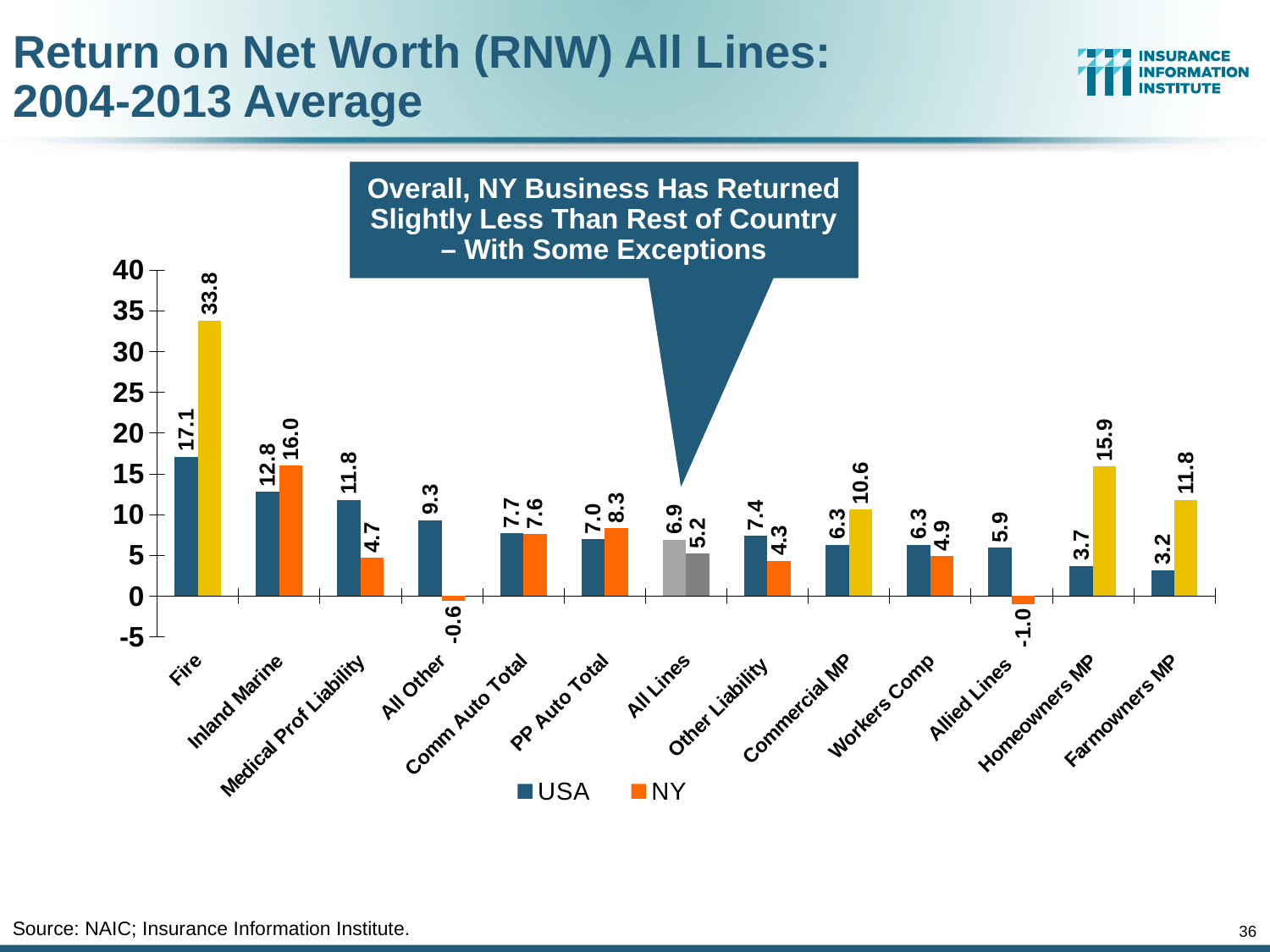
What is the USA value for All Lines? 6.9 What is the difference between the NY and USA values for Fire? 16.7 What is the NY value for All Other? -0.6 Which is larger for Medical Prof Liability, the USA value or the NY value? USA Which category has the lowest NY value? Allied Lines Is the NY value for Commercial MP greater or less than 10? greater What kind of chart is shown on the slide? bar chart How many series does the legend list? 2 How many categories are shown on the x axis? 13 What is the USA value for Fire? 17.1 Which category has the highest NY value? Fire What is the NY value for Homeowners MP? 15.9